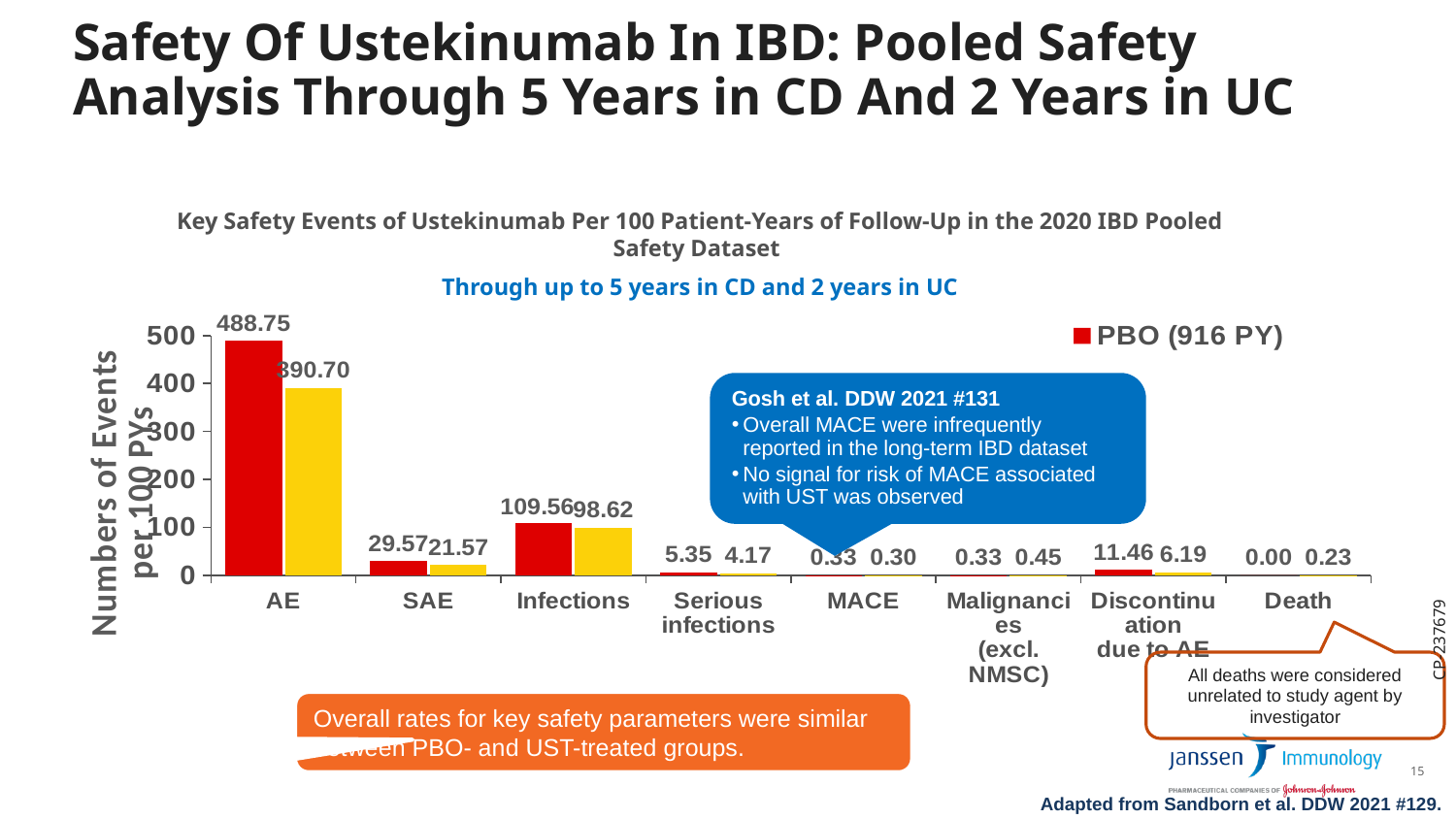
What is the difference between the PBO (916 PY) values for AE and SAE? 459.18 What type of chart is shown on the slide? bar chart Which category has the highest PBO (916 PY) value? AE What is the PBO (916 PY) value for Death? 0.00 How many categories are shown on the x axis of the chart? 8 What is the PBO (916 PY) value for AE? 488.75 Which has the larger PBO (916 PY) value, SAE or Serious infections? SAE What is the PBO (916 PY) value for Discontinuation due to AE? 11.46 Is the PBO (916 PY) value for AE greater or less than 400? greater What is the difference between the PBO (916 PY) values for Infections and Serious infections? 104.21 What is the PBO (916 PY) value for Infections? 109.56 Which category has the lowest PBO (916 PY) value? Death